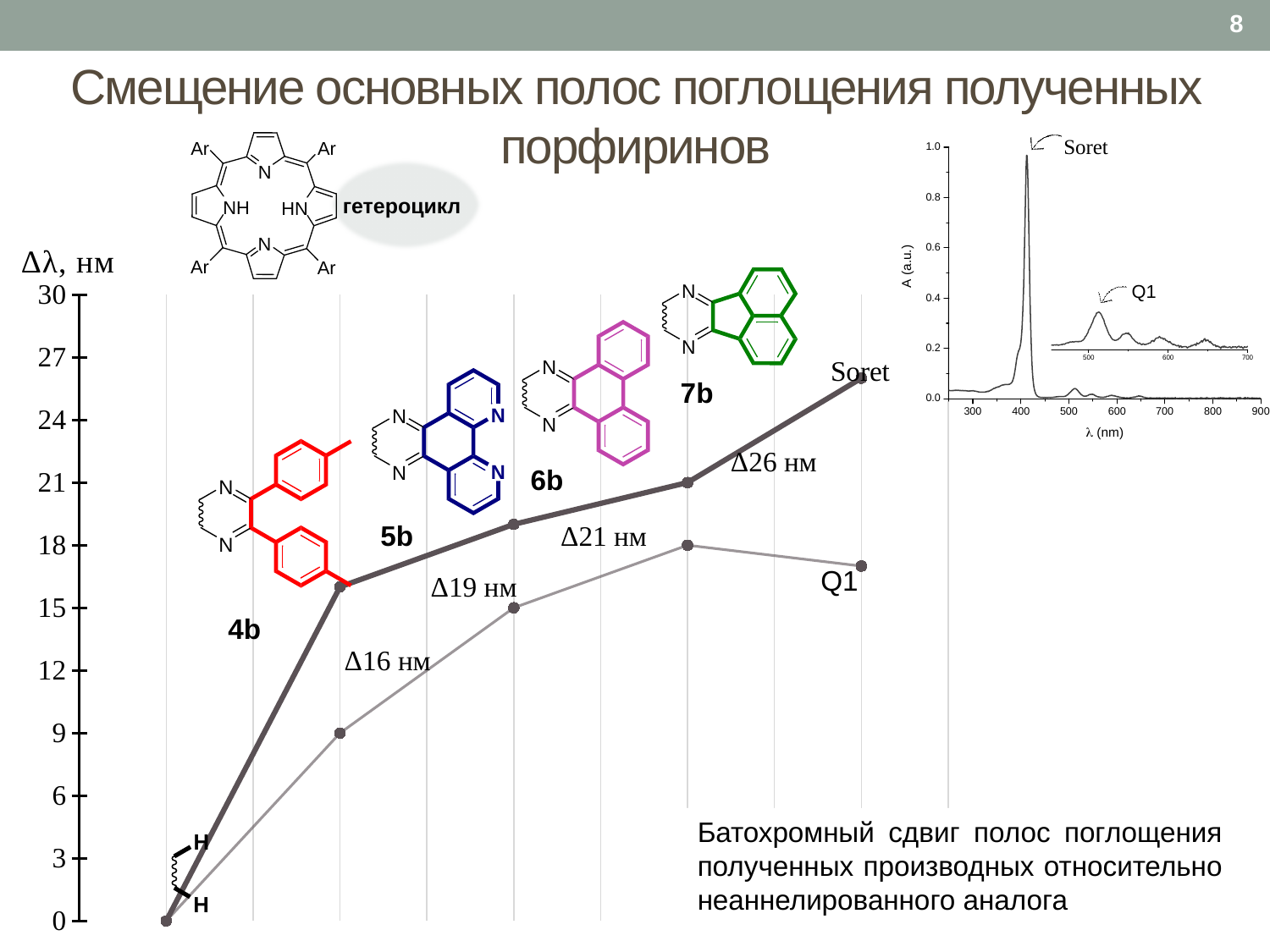
On the large line chart, what is the Soret band shift (Δλ) for compound 4b? 16 нм How many series are plotted on the large line chart? 2 On the large line chart, does the Soret series rise or fall from left to right? rise On the large line chart, what is the Soret band shift (Δλ) for compound 5b? 19 нм On the large line chart, what is the difference between the Soret shift of 7b and the Soret shift of 4b? 10 нм On the large line chart, which compound has the largest Soret band shift? 7b What kind of chart is the large chart on the slide? line chart On the large line chart, what is the Soret band shift (Δλ) for compound 7b? 26 нм On the large line chart, which series has the larger value for compound 6b, Soret or Q1? Soret What is the y-axis label of the large line chart? Δλ, нм On the large line chart, is the Q1 value for compound 7b greater or less than 15? greater On the large line chart, what is the Q1 band shift (Δλ) for compound 4b? 9